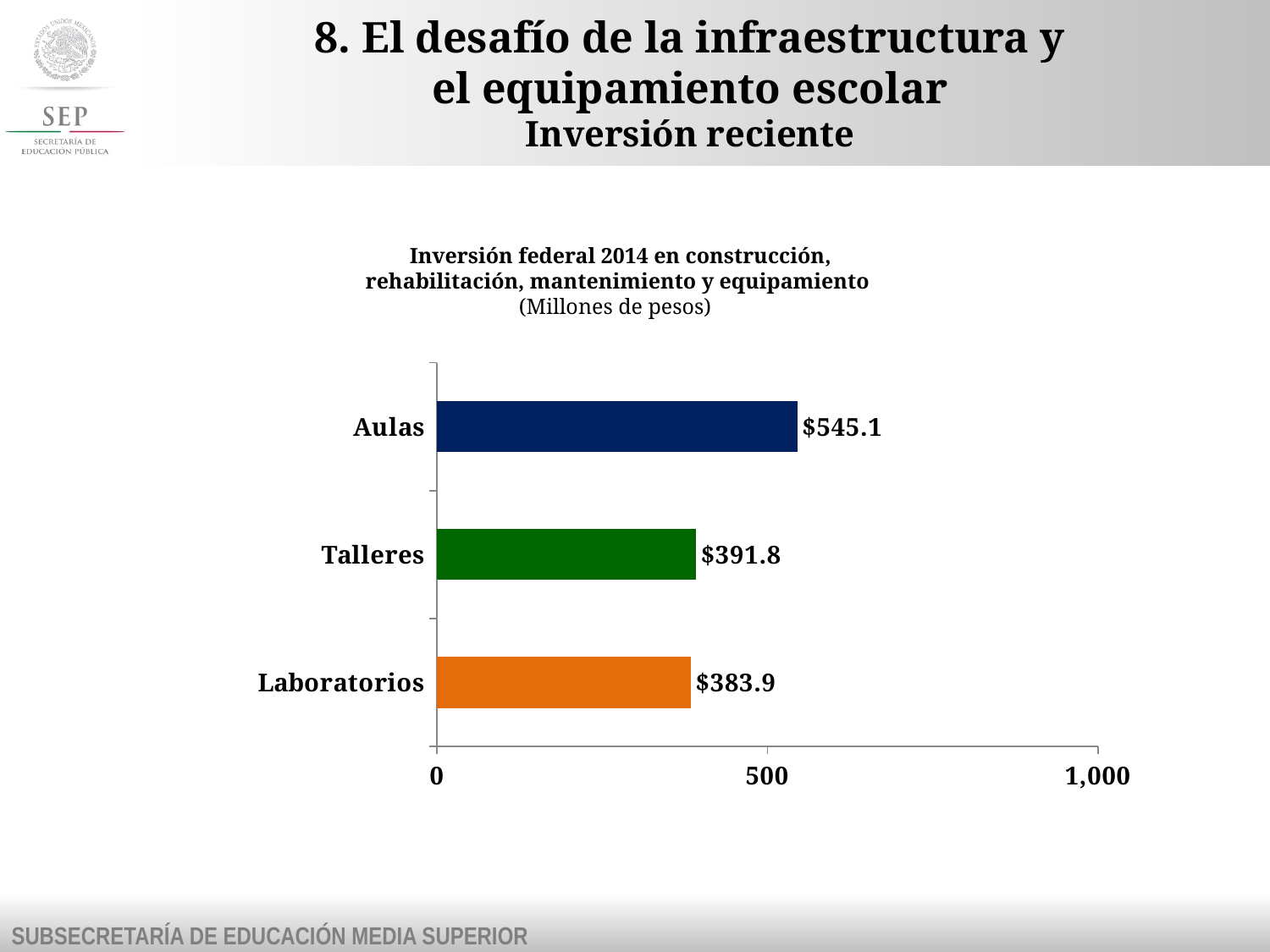
What is the value for Talleres? $391.8 How many categories are shown in the chart? 3 Which is larger, the value for Aulas or the value for Laboratorios? Aulas What kind of chart is shown on the slide? Bar chart What unit is stated in the chart title? Millones de pesos What is the value for Laboratorios? $383.9 Is the value for Aulas greater or less than 500? greater What is the value for Aulas? $545.1 What is the difference between the values for Talleres and Laboratorios? $7.9 Which category has the highest value? Aulas What is the difference between the values for Aulas and Talleres? $153.3 Which category has the lowest value? Laboratorios